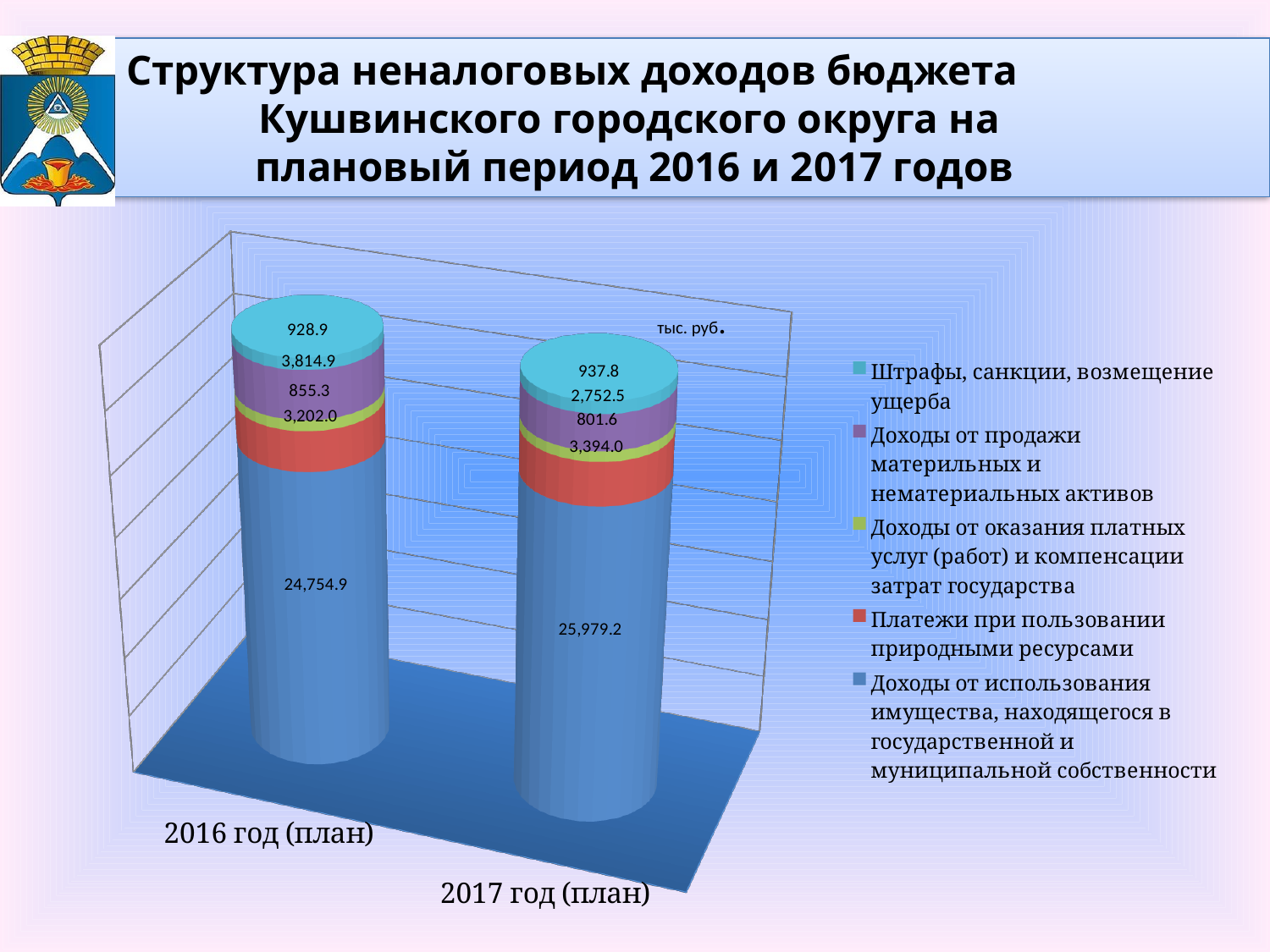
Which series has the smallest value in 2016 год (план)? Доходы от оказания платных услуг (работ) и компенсации затрат государства How many series does the legend list? 5 By how much does the value for 'Доходы от использования имущества' in 2017 год (план) exceed that in 2016 год (план)? 1,224.3 What is the value for 'Доходы от продажи материльных и нематериальных активов' in 2016 год (план)? 3,814.9 Which series has the largest value in 2017 год (план)? Доходы от использования имущества, находящегося в государственной и муниципальной собственности What is the value for 'Доходы от использования имущества, находящегося в государственной и муниципальной собственности' in 2016 год (план)? 24,754.9 What is the value for 'Штрафы, санкции, возмещение ущерба' in 2017 год (план)? 937.8 Is the value for 'Доходы от продажи материльных и нематериальных активов' larger in 2016 год (план) or 2017 год (план)? 2016 год (план) What is the value for 'Платежи при пользовании природными ресурсами' in 2017 год (план)? 3,394.0 How many categories (years) are plotted on the chart? 2 What type of chart is shown on the slide? Stacked bar chart What is the total of the stacked bar for 2017 год (план)? 33,865.1